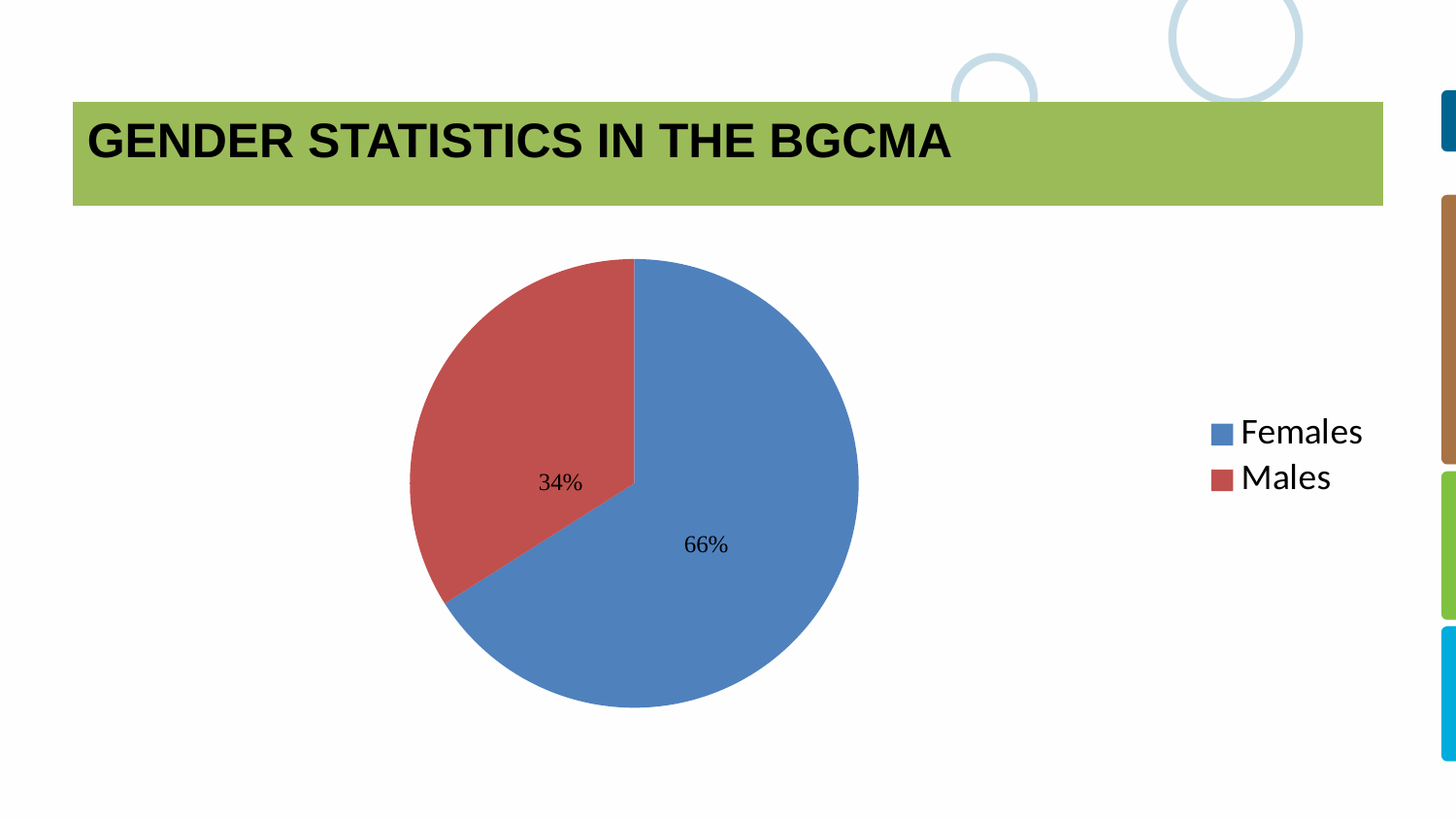
What colour is the Males slice? red Which slice is larger, Females or Males? Females How many categories does the pie chart show? 2 Which category has the largest slice of the pie? Females Which category has the smallest slice of the pie? Males What is the difference in percentage points between the Females and Males slices? 32 What is the title of the slide containing the chart? GENDER STATISTICS IN THE BGCMA What share of the pie is Males? 34% How many entries does the legend list? 2 What type of chart is shown on the slide? pie chart What share of the pie is Females? 66%